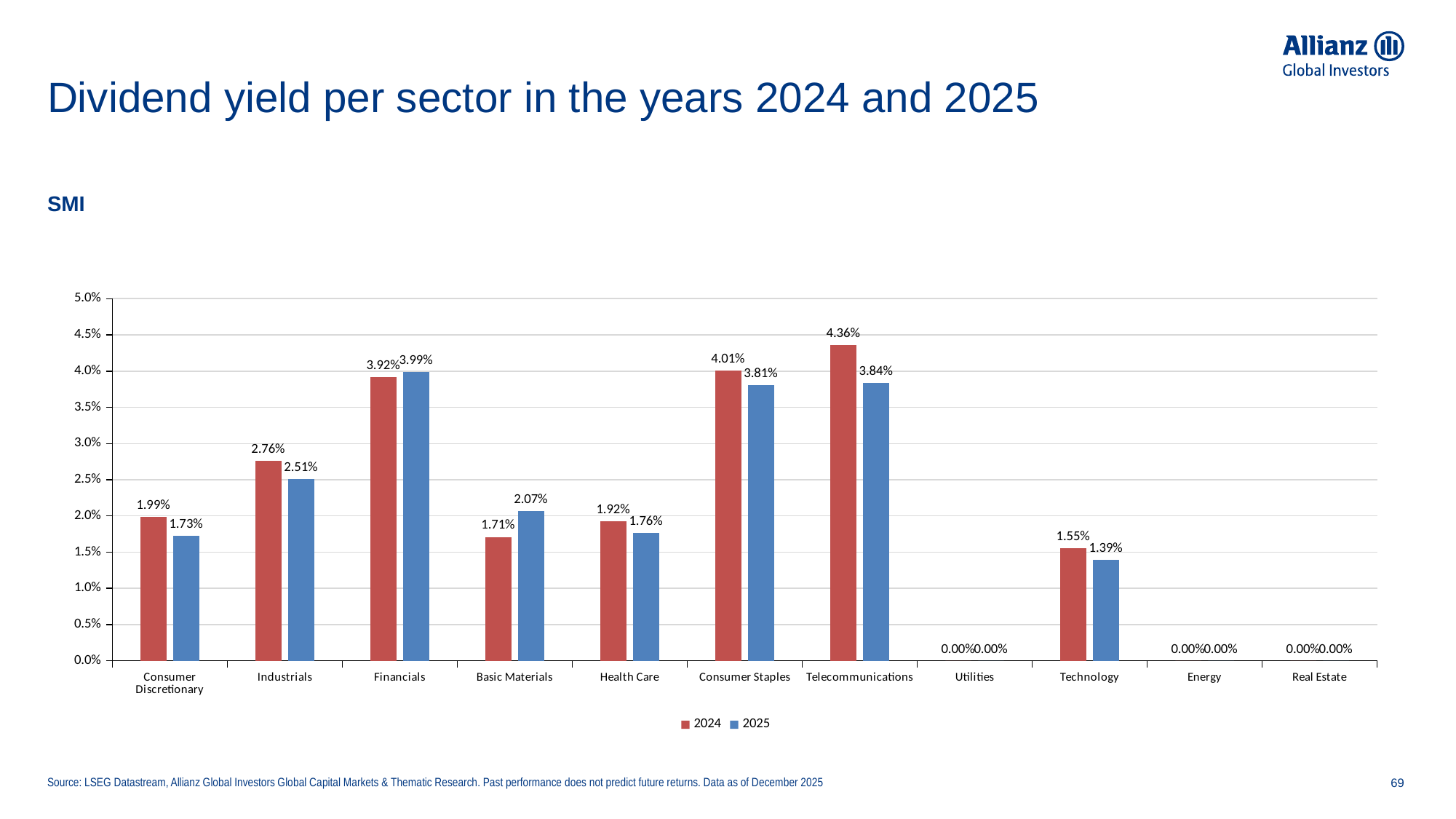
Is the 2024 dividend yield for Consumer Staples higher or lower than its 2025 yield? higher What is the 2025 dividend yield for Basic Materials? 2.07% How many series does the legend list? 2 How many sectors are shown on the x axis? 11 Which sector has the highest 2025 dividend yield? Financials What is the difference between the 2024 and 2025 dividend yields for Industrials? 0.25% Which sector has the highest 2024 dividend yield? Telecommunications What kind of chart is shown on the slide? bar chart What is the 2025 dividend yield for Financials? 3.99% Which colour represents the 2025 series? blue What is the 2024 dividend yield for Telecommunications? 4.36% Among sectors with a non-zero yield, which has the lowest 2025 dividend yield? Technology